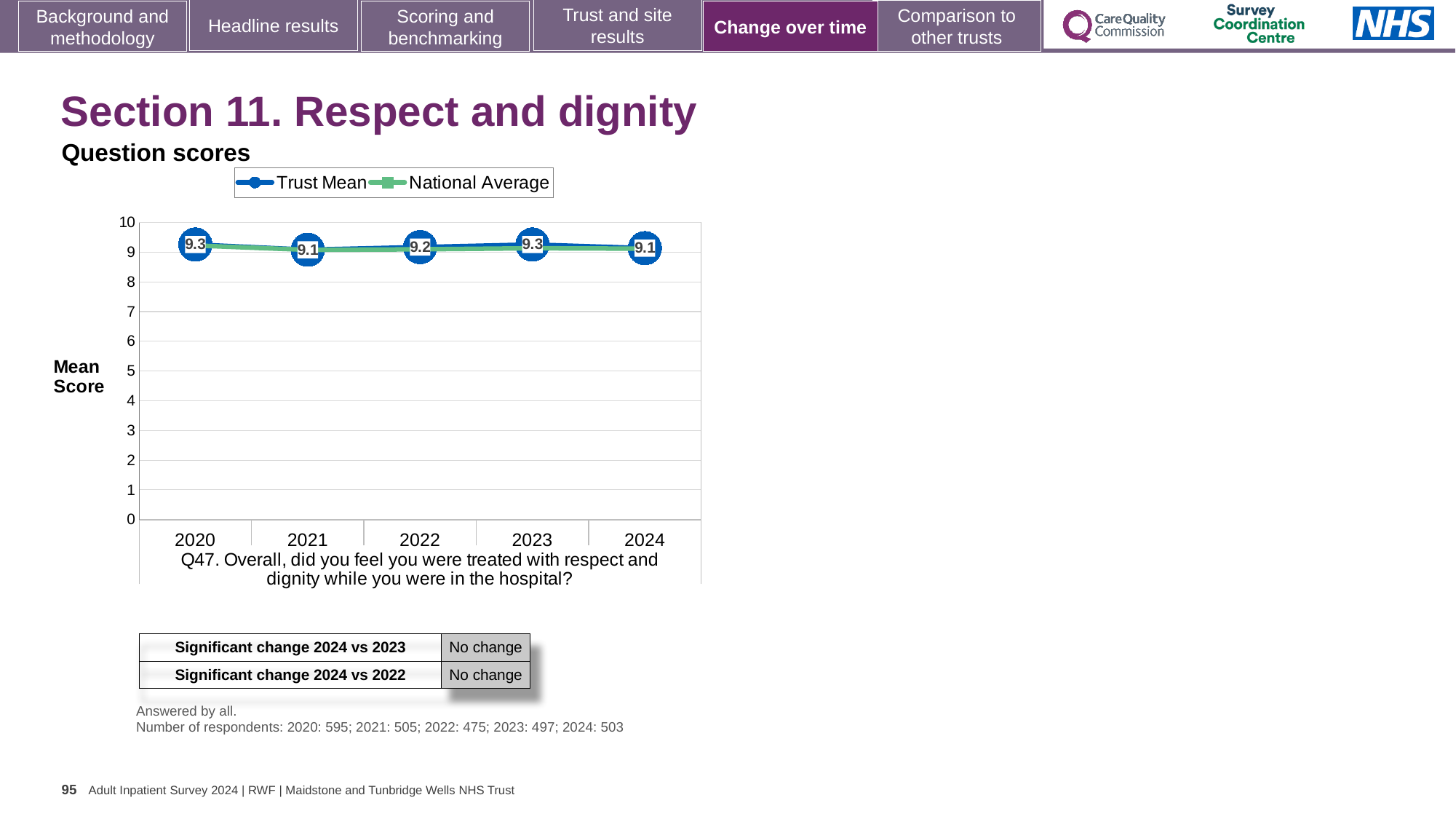
How many series does the chart legend list? 2 What is the Trust Mean score for 2022? 9.2 What is the difference between the Trust Mean scores for 2020 and 2021? 0.2 What is the Trust Mean score for 2020? 9.3 Which year has the larger Trust Mean score, 2023 or 2024? 2023 What are the two series named in the chart legend? Trust Mean and National Average Is the National Average value for 2022 greater or less than 8? greater What is the Trust Mean score for 2021? 9.1 What is the label on the y axis of the chart? Mean Score How many years are plotted on the x axis of the chart? 5 What is the Trust Mean score for 2024? 9.1 What kind of chart is shown on the slide? Line chart